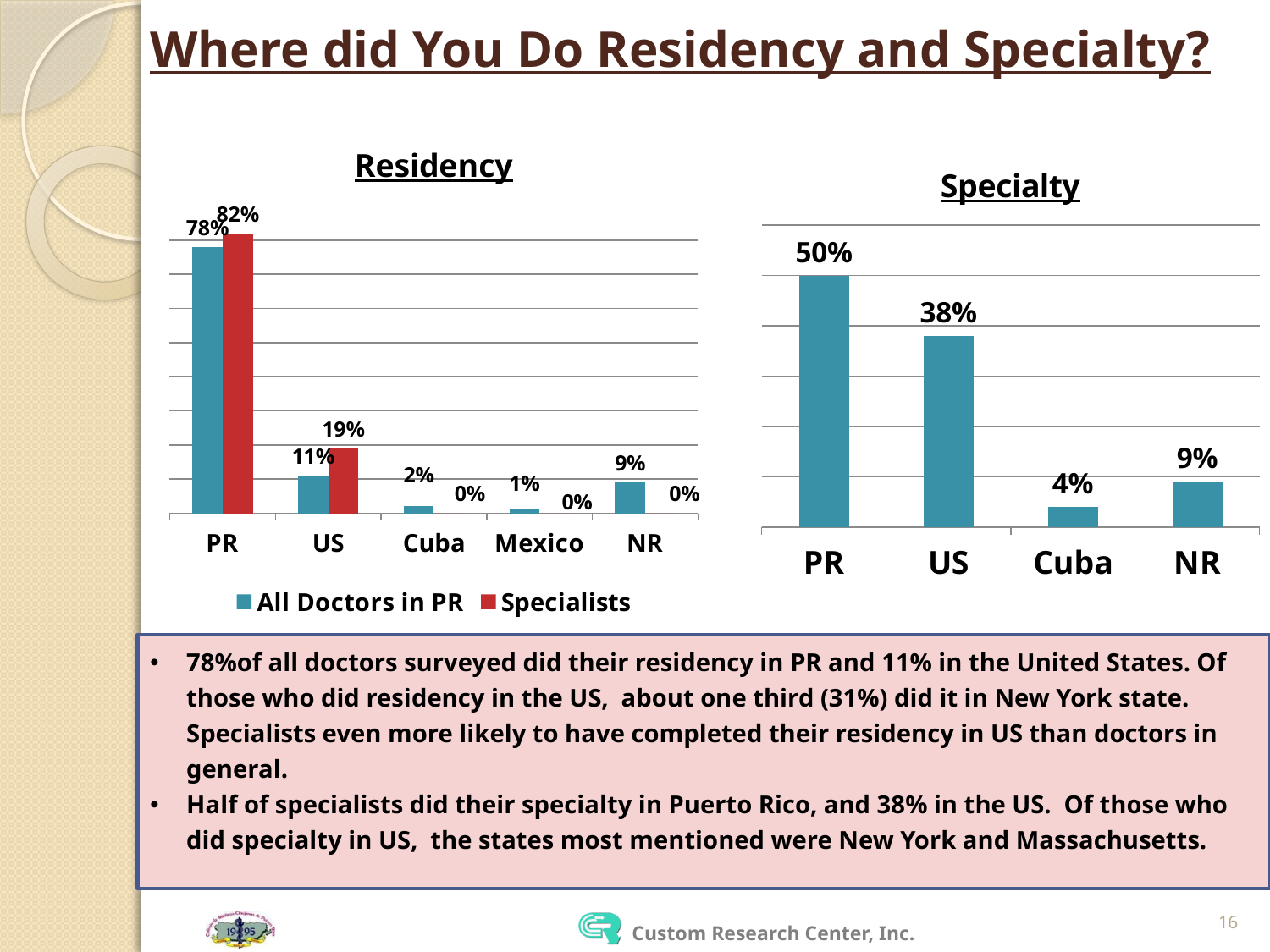
In the Residency chart, what is the value for All Doctors in PR for NR? 9% In the Residency chart, what is the value for All Doctors in PR for the US category? 11% What kind of chart is the Specialty chart? Bar chart In the Residency chart, how many categories are shown on the x axis? 5 In the Specialty chart, what is the difference between the PR and US values? 12% In the Residency chart, how many series does the legend list? 2 In the Residency chart, what is the difference between the Specialists and All Doctors in PR values for PR? 4% In the Residency chart, what is the value for Specialists in PR? 82% In the Residency chart, what is the value for Specialists in the US category? 19% In the Specialty chart, which category has the lowest value? Cuba In the Specialty chart, which is larger, the value for Cuba or the value for NR? NR In the Specialty chart, what is the value for US? 38%